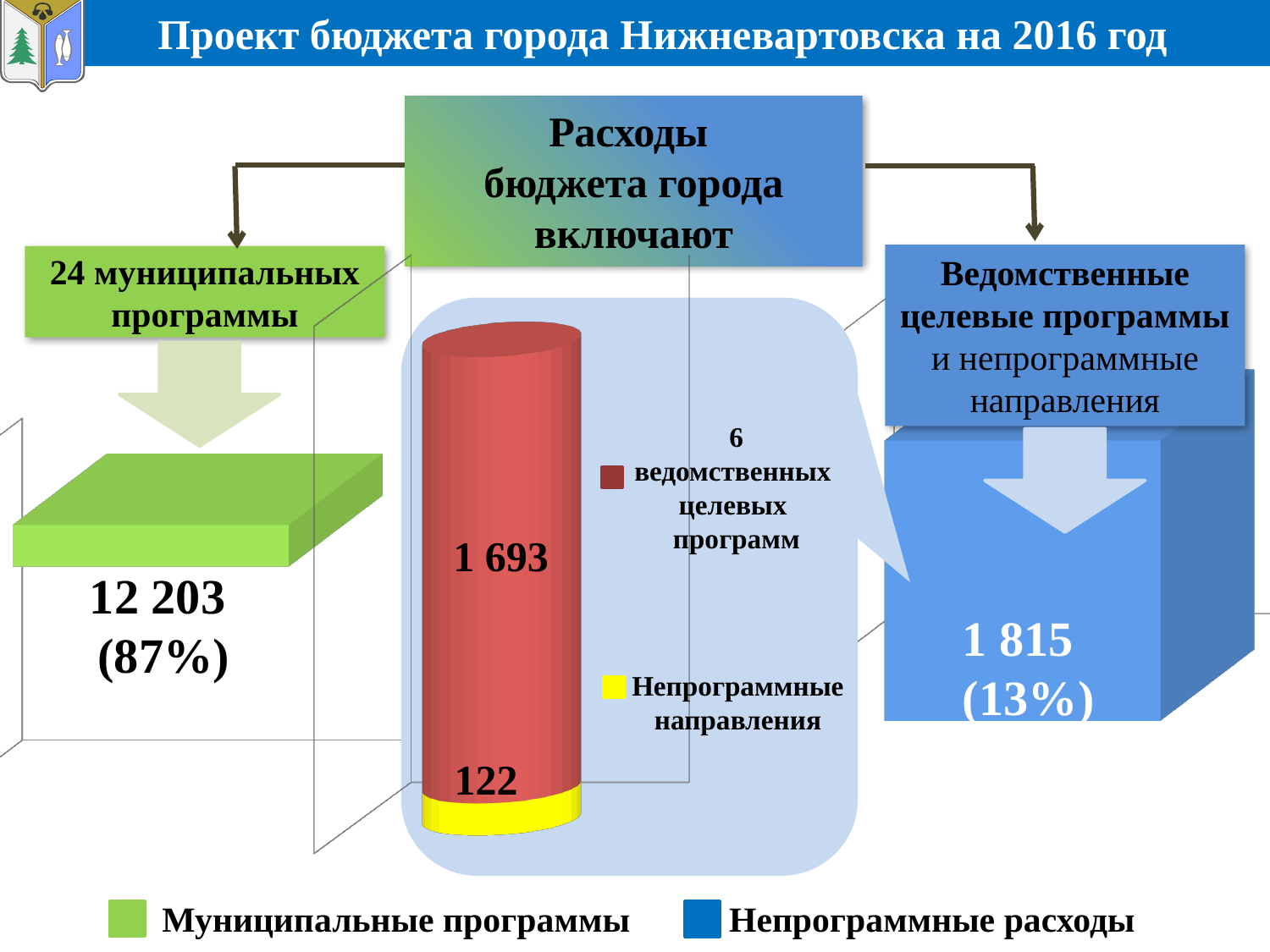
In the 3D bar chart with the green and blue blocks, what is the value for 'Непрограммные расходы'? 1 815 (13%) In the 3D bar chart with the green and blue blocks, which category is the highest? Муниципальные программы In the 3D bar chart with the green and blue blocks, what is the value for 'Муниципальные программы'? 12 203 (87%) In the 3D bar chart with the green and blue blocks, what share of the total do 'Непрограммные расходы' make up? 13% In the stacked cylinder chart in the centre, which segment is larger: 'ведомственных целевых программ' or 'Непрограммные направления'? ведомственных целевых программ In the stacked cylinder chart in the centre, what is the value for the red segment 'ведомственных целевых программ'? 1 693 In the stacked cylinder chart in the centre, what is the total of the two segments? 1 815 In the 3D bar chart with the green and blue blocks, what is the difference between 'Муниципальные программы' and 'Непрограммные расходы'? 10 388 In the stacked cylinder chart in the centre, how many segments does the legend list? 2 In the stacked cylinder chart in the centre, what is the difference between the 'ведомственных целевых программ' segment and the 'Непрограммные направления' segment? 1 571 In the stacked cylinder chart in the centre, what colour is the 'Непрограммные направления' segment? Yellow In the stacked cylinder chart in the centre, what is the value for the yellow segment 'Непрограммные направления'? 122